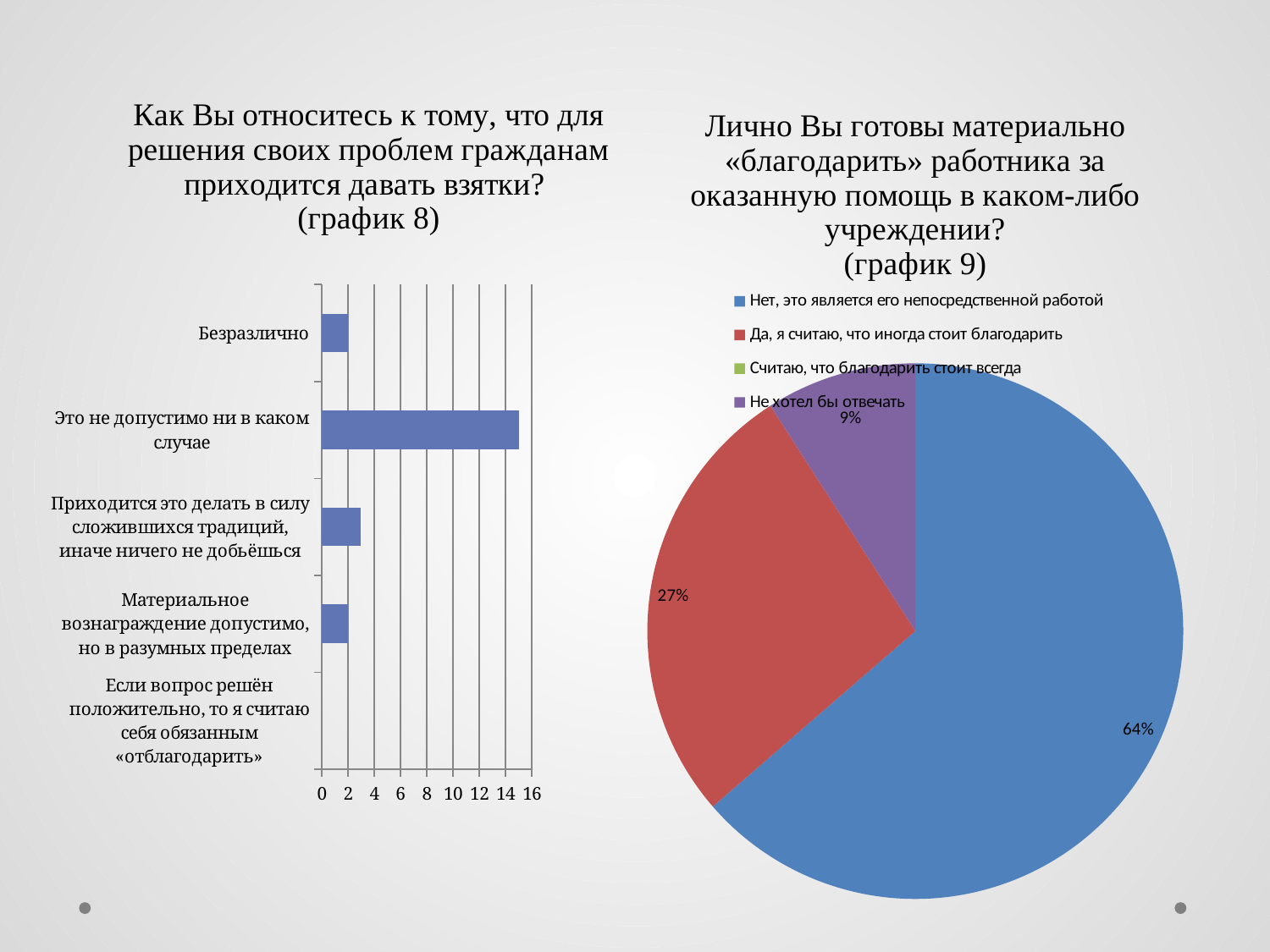
What kind of chart is график 9 (the right chart)? pie chart In график 9 (the pie chart), what is the difference between the 64% slice and the 27% slice? 37% In график 9 (the pie chart), what share is labelled for 'Не хотел бы отвечать'? 9% How many entries does the legend of график 9 (the pie chart) list? 4 In график 8 (the left chart), which is larger: the value for 'Это не допустимо ни в каком случае' or the value for 'Безразлично'? Это не допустимо ни в каком случае In график 9 (the pie chart), what share is labelled for 'Нет, это является его непосредственной работой'? 64% In график 8 (the left chart), is the value for 'Это не допустимо ни в каком случае' greater or less than 10? greater What kind of chart is график 8 (the left chart)? bar chart In график 8 (the left chart), is the value for 'Приходится это делать в силу сложившихся традиций, иначе ничего не добьёшься' greater or less than 6? less In график 9 (the pie chart), what share is labelled for 'Да, я считаю, что иногда стоит благодарить'? 27% In график 8 (the left chart), which category has the highest value? Это не допустимо ни в каком случае In график 8 (the left chart), how many categories are shown on the vertical axis? 5